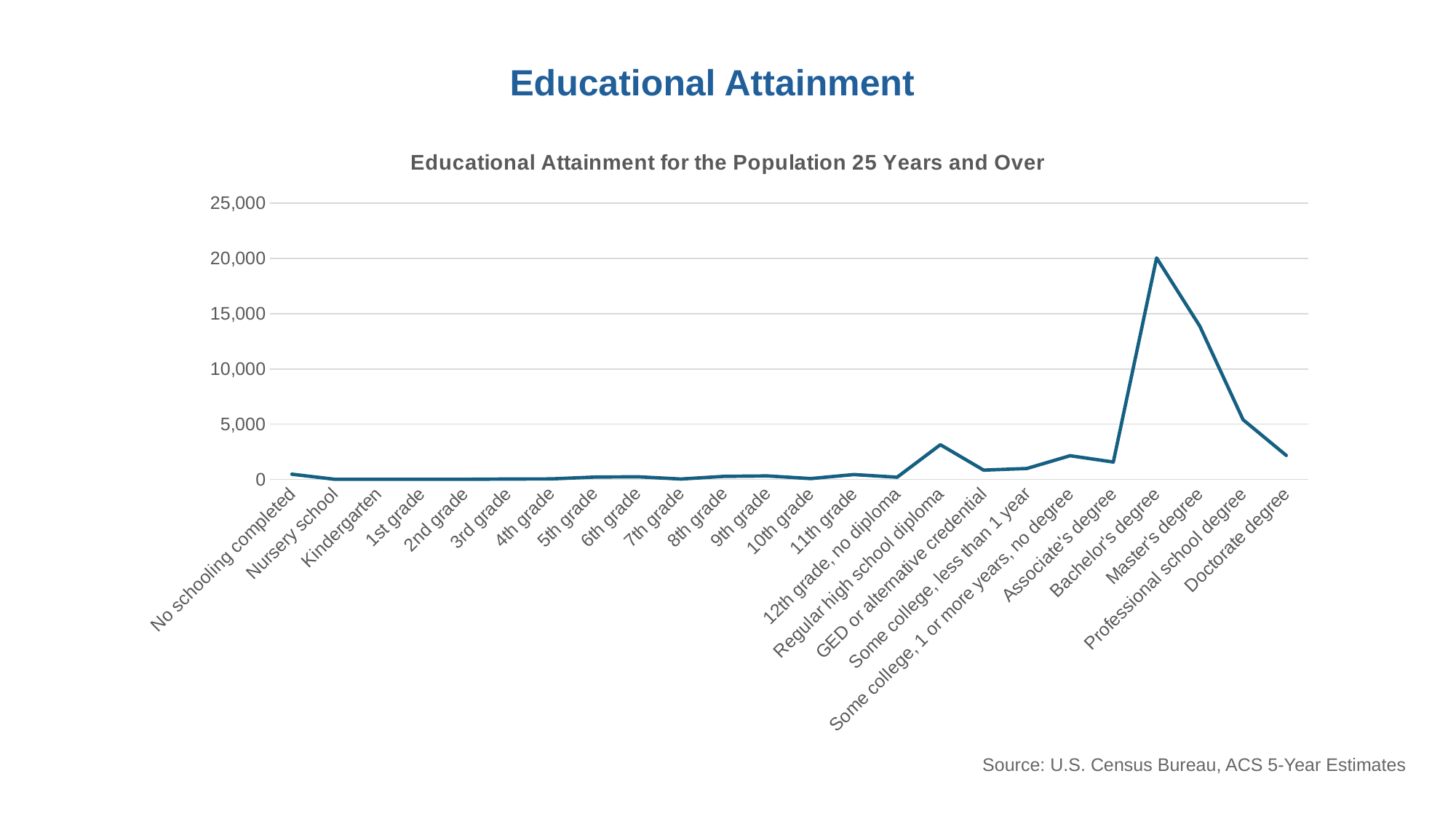
What kind of chart is shown on the slide? Line chart Is the value for Bachelor's degree greater or less than 15,000? greater Is the value for Master's degree greater or less than 15,000? less Is the value for Professional school degree greater or less than 10,000? less Which category has the highest value in the chart? Bachelor's degree Do the values rise or fall from Bachelor's degree to Doctorate degree? Fall Which is larger, the value for Regular high school diploma or the value for GED or alternative credential? Regular high school diploma What is the title of the chart? Educational Attainment for the Population 25 Years and Over Which is larger, the value for Bachelor's degree or the value for Master's degree? Bachelor's degree How many categories are plotted along the x axis? 24